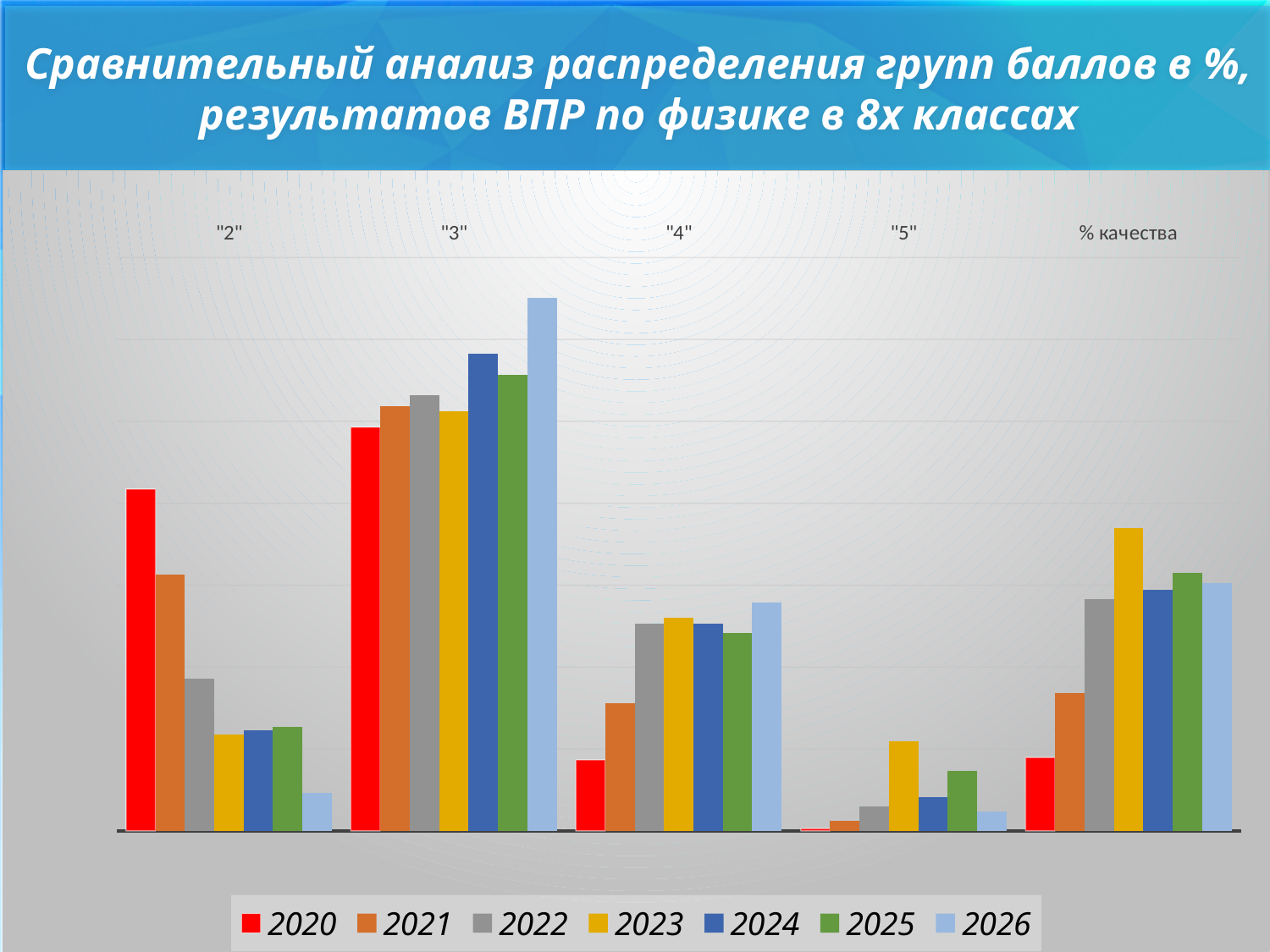
Which year has the highest value in the "2" category? 2020 Do the values in the "2" category generally rise or fall from 2020 to 2026? fall What kind of chart is shown on the slide? bar chart Which year has the highest value in the "% качества" category? 2023 Which series is shown in red in the legend? 2020 In the "4" category, which is larger: the value for 2020 or the value for 2026? 2026 Which year has the highest value in the "3" category? 2026 Which year has the lowest value in the "2" category? 2026 How many series does the legend list? 7 Which year has the lowest value in the "% качества" category? 2020 How many categories are shown along the x axis? 5